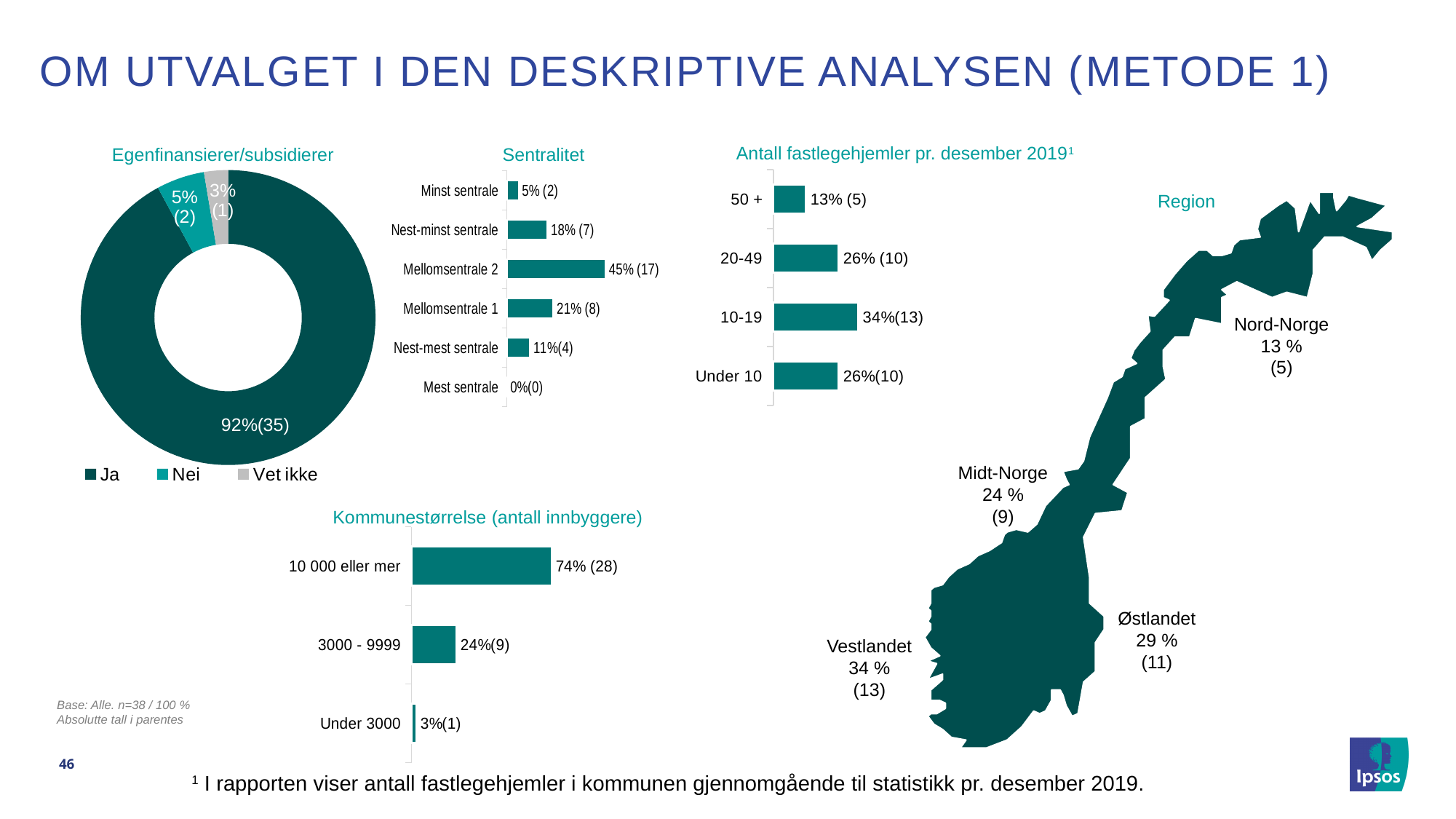
In the 'Kommunestørrelse (antall innbyggere)' chart, what is the difference in percentage points between '10 000 eller mer' and '3000 - 9999'? 50 percentage points In the 'Sentralitet' chart, how many categories are shown? 6 What kind of chart is the 'Egenfinansierer/subsidierer' chart? Donut (pie) chart How many entries does the legend of the 'Egenfinansierer/subsidierer' chart list? 3 What kind of chart is the 'Kommunestørrelse (antall innbyggere)' chart? Bar chart In the 'Antall fastlegehjemler pr. desember 2019' chart, which category has the lowest value? 50 + In the 'Region' map, which region has a larger share: Vestlandet or Østlandet? Vestlandet In the 'Egenfinansierer/subsidierer' chart, how many respondents answered 'Nei' (the number in parentheses)? 2 In the 'Antall fastlegehjemler pr. desember 2019' chart, what is the value for '10-19'? 34%(13) In the 'Sentralitet' chart, which category has the highest value? Mellomsentrale 2 In the 'Egenfinansierer/subsidierer' chart, what percentage is shown for 'Ja'? 92% In the 'Sentralitet' chart, what is the value for 'Mellomsentrale 1'? 21% (8)